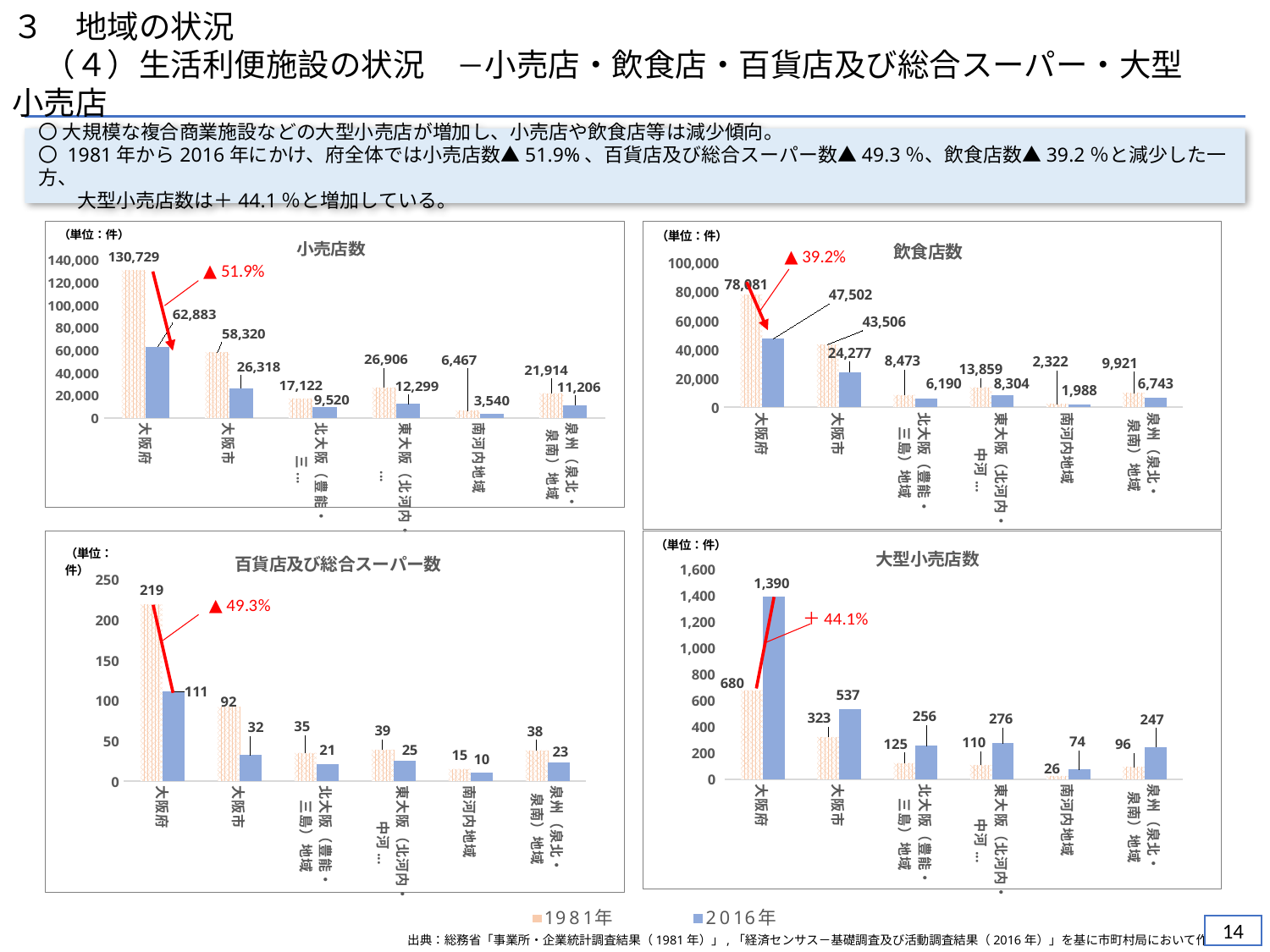
In the 大型小売店数 chart, which region has the highest 2016年 value? 大阪府 How many series does the legend at the bottom of the slide list? 2 In the 飲食店数 chart, which region has the lowest 2016年 value? 南河内地域 In the 飲食店数 chart, what is the 2016年 value for 大阪府? 47,502 How many regions are shown on the x axis of the 飲食店数 chart? 6 What type of chart is the 小売店数 chart? bar chart In the 小売店数 chart, what is the 1981年 value for 東大阪 (北河内・中河内) 地域? 26,906 In the 小売店数 chart, what is the 2016年 value for 大阪市? 26,318 In the 大型小売店数 chart, what is the difference between the 2016年 and 1981年 values for 南河内地域? 48 In the 百貨店及び総合スーパー数 chart, what is the 2016年 value for 泉州 (泉北・泉南) 地域? 23 In the 大型小売店数 chart, is the 2016年 value for 大阪市 larger or smaller than the 1981年 value? larger In the 百貨店及び総合スーパー数 chart, what is the difference between the 1981年 and 2016年 values for 大阪府? 108